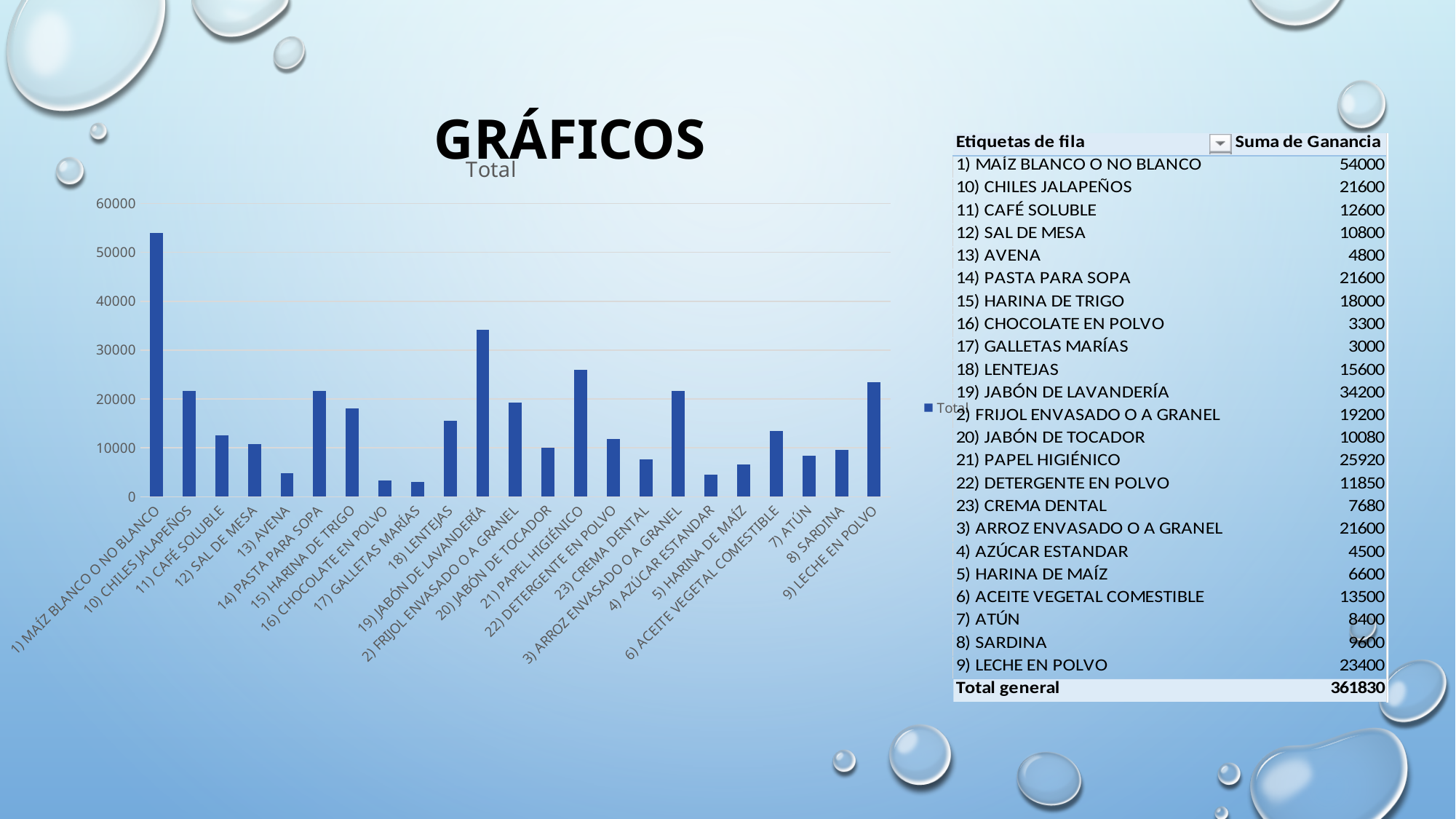
How many series does the chart legend list? 1 Is the value for 19) JABÓN DE LAVANDERÍA greater or less than 30000? greater What is the value for 1) MAÍZ BLANCO O NO BLANCO? 54000 What is the difference between the value for 1) MAÍZ BLANCO O NO BLANCO and the value for 10) CHILES JALAPEÑOS? 32400 What is the value for 19) JABÓN DE LAVANDERÍA? 34200 What is the title of the chart? Total What is the value for 9) LECHE EN POLVO? 23400 What kind of chart is shown on the slide? bar chart How many categories are plotted on the x axis of the chart? 23 Which category has the highest bar in the chart? 1) MAÍZ BLANCO O NO BLANCO Is the value for 13) AVENA greater or less than 10000? less Which is larger, the value for 19) JABÓN DE LAVANDERÍA or the value for 21) PAPEL HIGIÉNICO? 19) JABÓN DE LAVANDERÍA